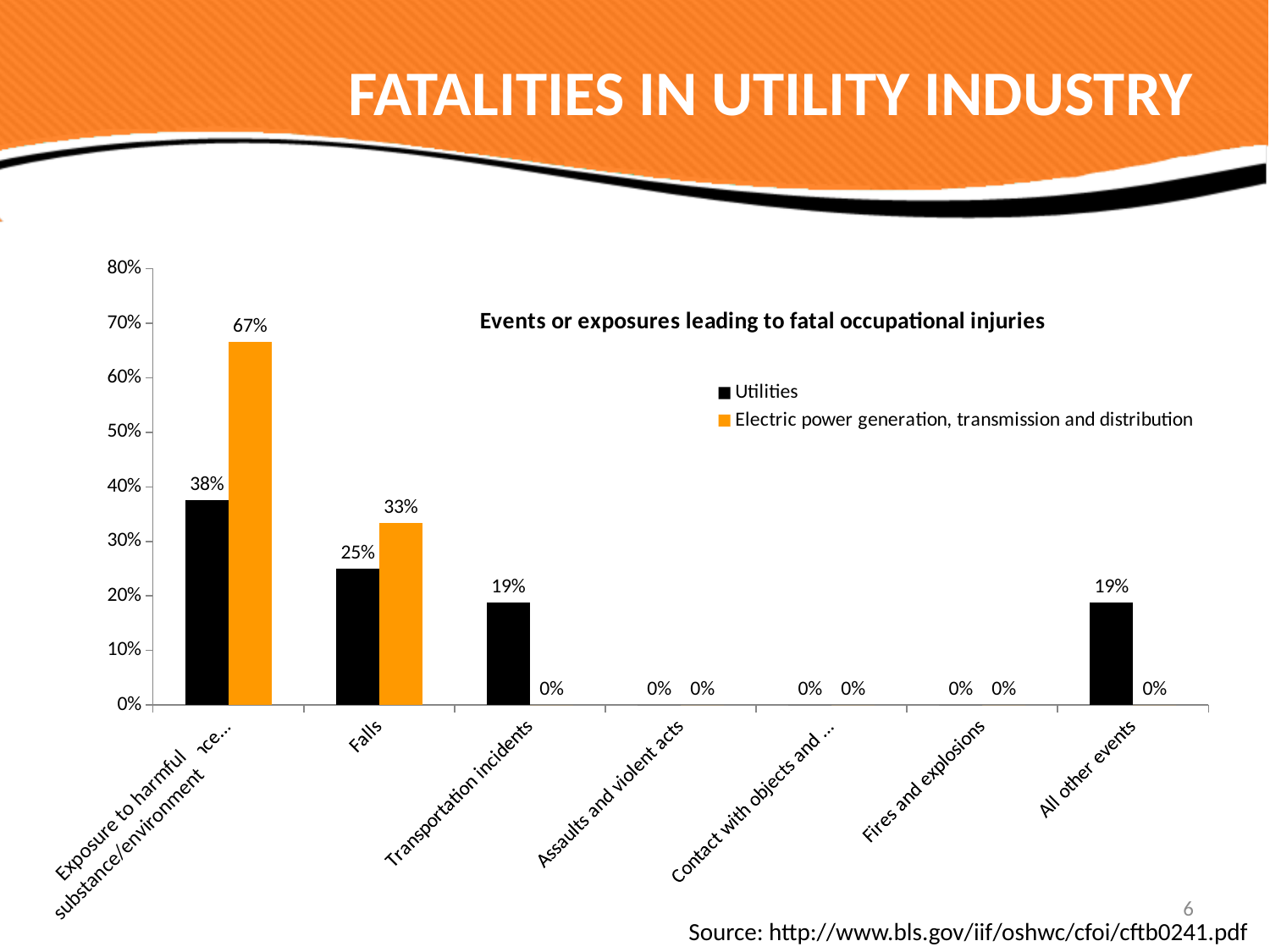
How many series does the legend list? 2 What is the Utilities value for Transportation incidents? 19% How many categories are shown on the x axis? 7 What kind of chart is shown on the slide? Bar chart What is the value for Electric power generation, transmission and distribution for Falls? 33% What is the Utilities value for Falls? 25% For Falls, which series has the larger value, Utilities or Electric power generation, transmission and distribution? Electric power generation, transmission and distribution Which category has the highest value for the Electric power generation, transmission and distribution series? Exposure to harmful substance/environment What is the title of the chart? Events or exposures leading to fatal occupational injuries What is the difference between the Electric power generation, transmission and distribution value and the Utilities value for Falls? 8% What is the value for Electric power generation, transmission and distribution for All other events? 0% Which category has the highest Utilities value? Exposure to harmful substance/environment